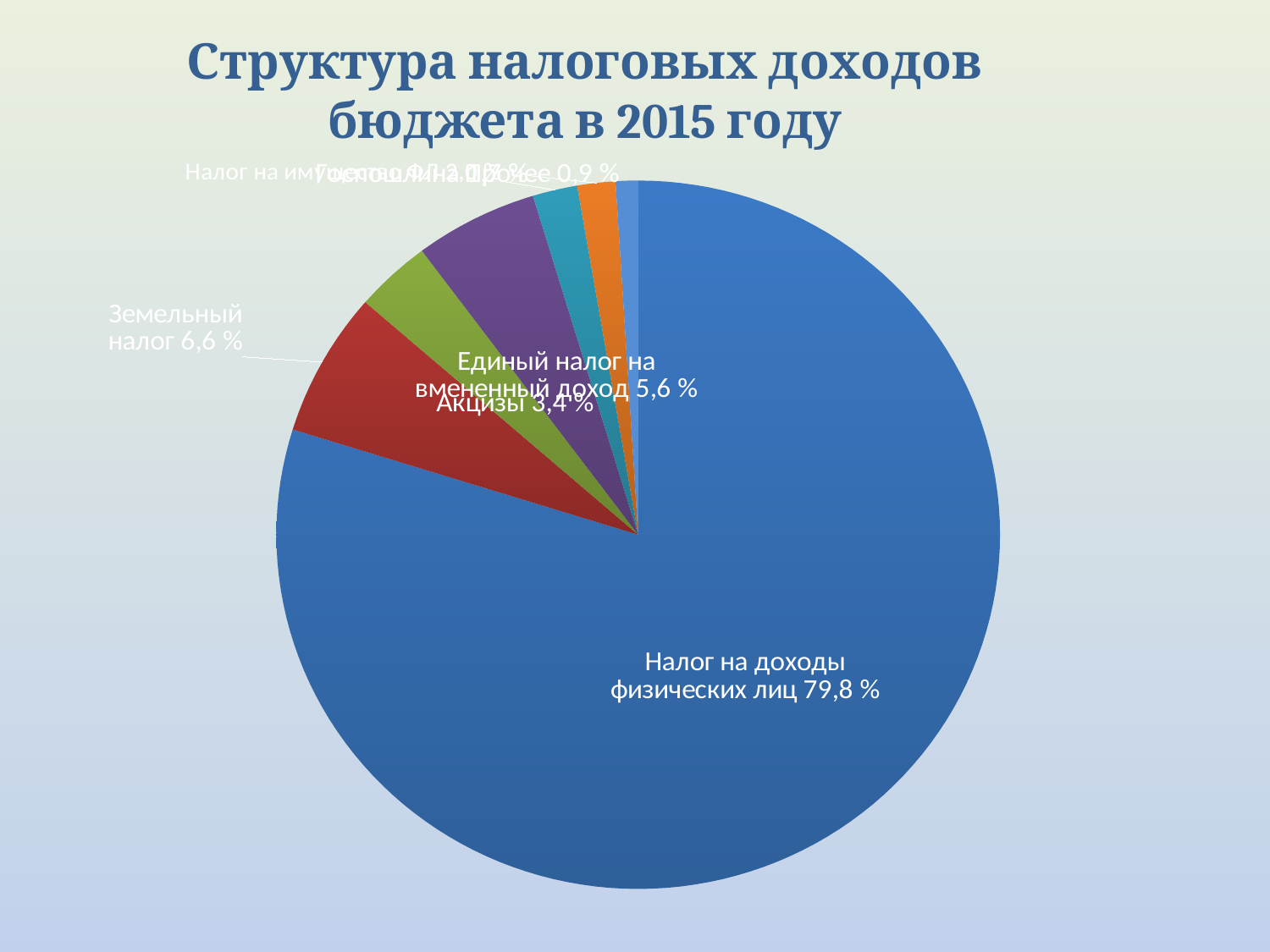
How many slices does the pie chart have? 7 What is the value shown for Прочее? 0,9 % What is the difference between Налог на доходы физических лиц and Земельный налог? 73,2 % Which is larger, Земельный налог or Акцизы? Земельный налог What is the value shown for Акцизы? 3,4 % What is the difference between Единый налог на вмененный доход and Акцизы? 2,2 % What share of tax revenues does Налог на доходы физических лиц account for? 79,8 % What is the value shown for Земельный налог? 6,6 % Which category has the largest slice of the pie? Налог на доходы физических лиц What is the title of the chart? Структура налоговых доходов бюджета в 2015 году What is the value shown for Единый налог на вмененный доход? 5,6 % What kind of chart is shown on the slide? pie chart